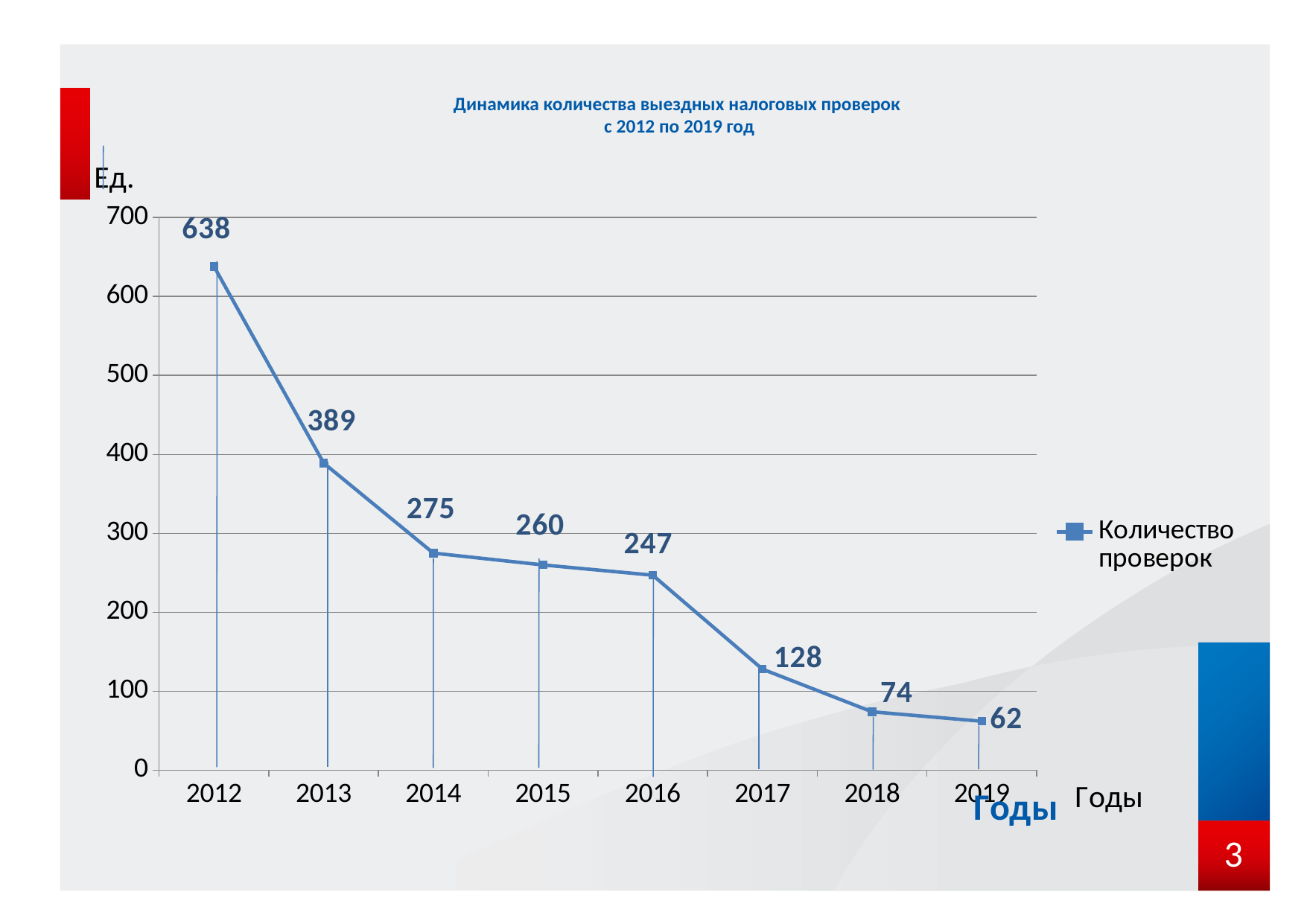
What is the number of inspections (Количество проверок) in 2012? 638 What is the difference between the number of inspections in 2017 and 2018? 54 What kind of chart is shown on the slide? Line chart What is the difference between the number of inspections in 2012 and 2013? 249 Which year has the highest number of inspections? 2012 Which year has more inspections, 2014 or 2015? 2014 Do the values rise or fall from 2012 to 2019? Fall Which year has the lowest number of inspections? 2019 What is the number of inspections in 2016? 247 What is the number of inspections in 2019? 62 How many years (data points) are plotted on the chart? 8 How many series does the legend list? 1